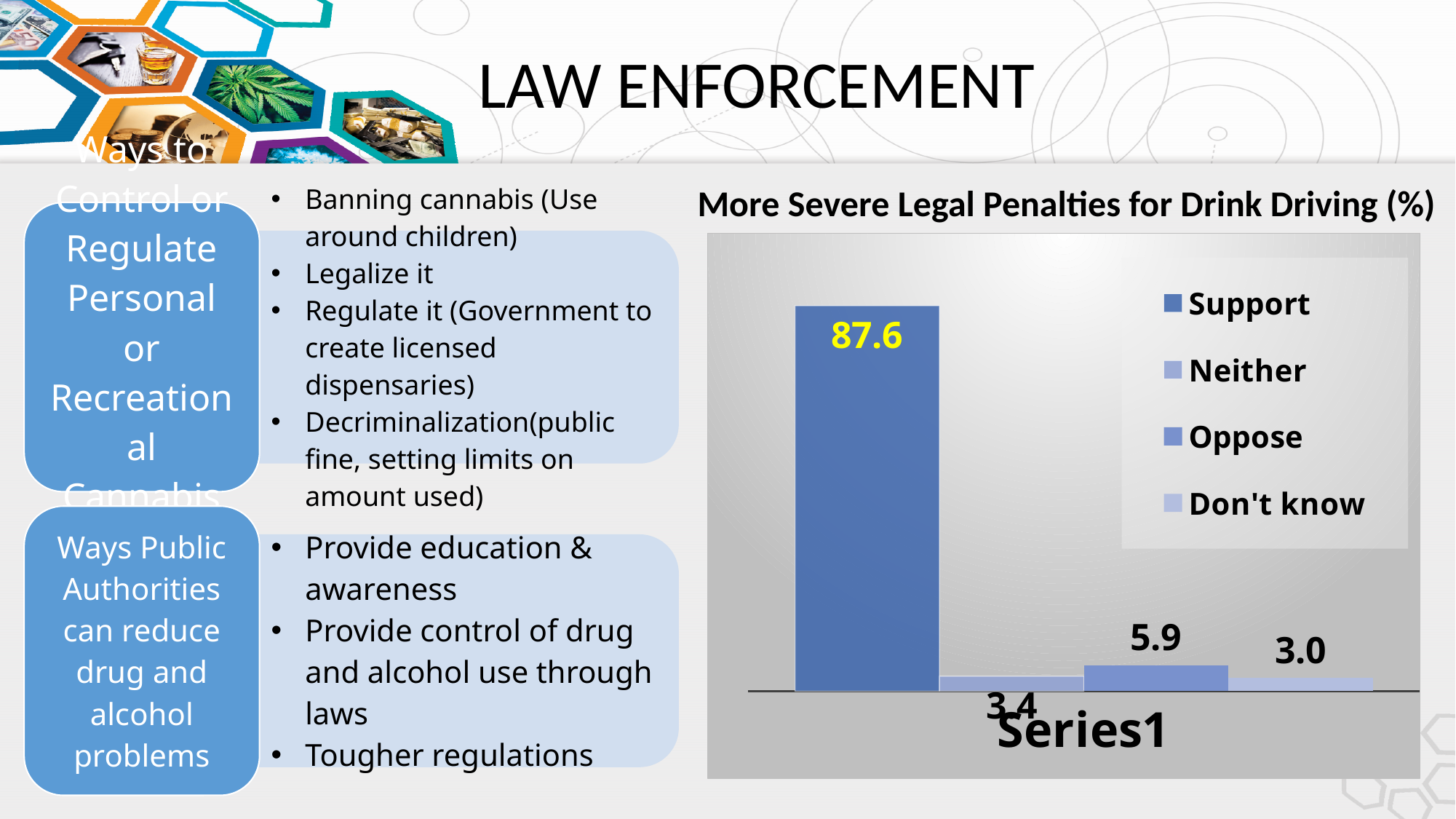
Which series has the highest value in the chart? Support Which series has the lowest value in the chart? Don't know What is the value for Support in the chart? 87.6 What is the difference between the Oppose and Don't know values? 2.9 What is the value for Neither in the chart? 3.4 What is the value for Don't know in the chart? 3.0 What is the difference between the Support and Oppose values? 81.7 How many series does the legend list? 4 Which is larger, the value for Oppose or the value for Neither? Oppose What is the title of the chart? More Severe Legal Penalties for Drink Driving (%) What is the value for Oppose in the chart? 5.9 What kind of chart is shown on the slide? bar chart